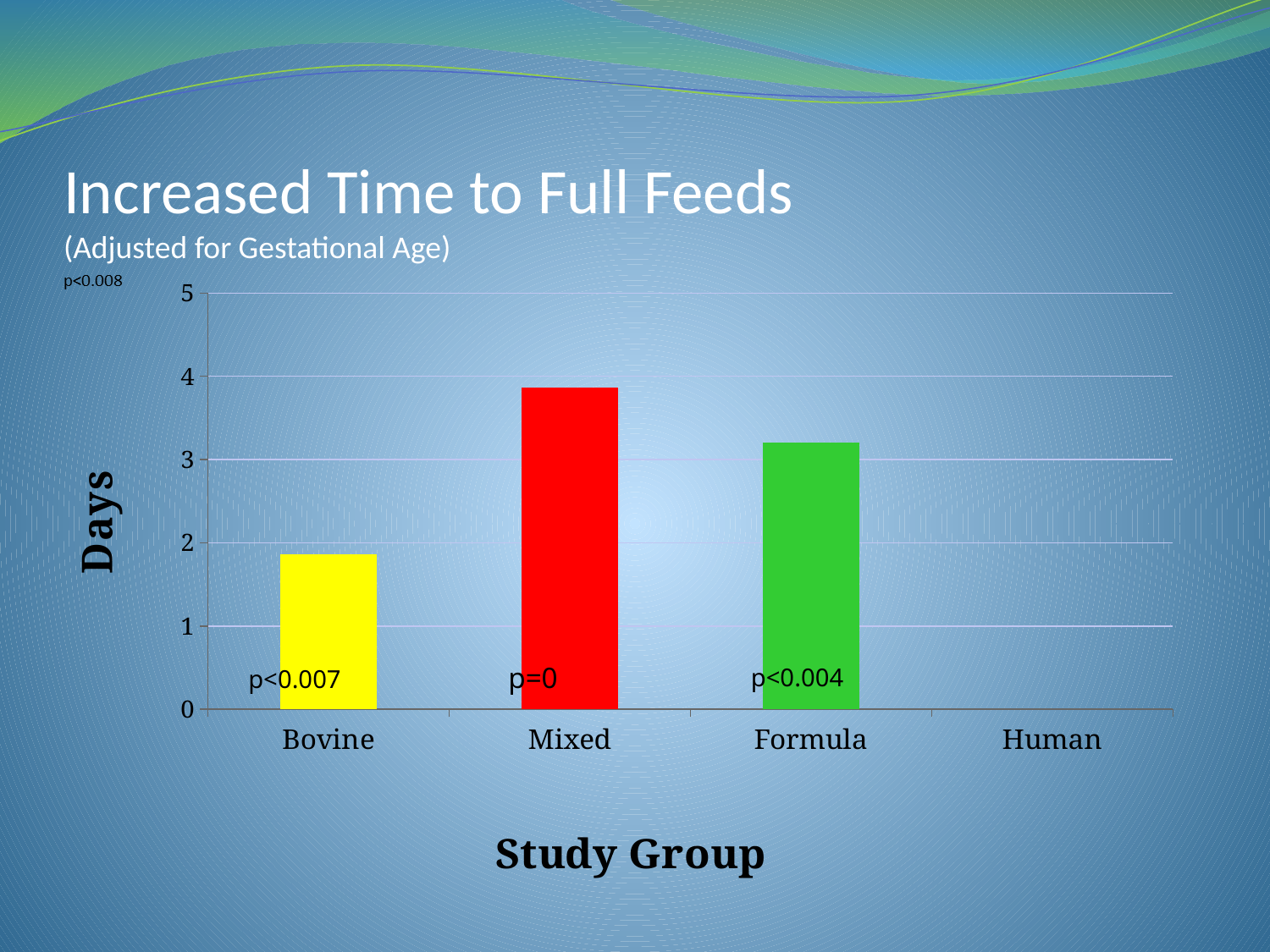
What kind of chart is shown on the slide? bar chart Is the value for Bovine greater or less than 2 days? less Is the value for Mixed greater or less than 4 days? less Which study group has the tallest bar? Mixed Which study group has no visible bar (the lowest value)? Human Is the value for Mixed greater or less than 3 days? greater Which has the larger value, Mixed or Formula? Mixed What is the label on the y axis of the chart? Days How many study groups are listed along the x axis? 4 Which has the larger value, Bovine or Formula? Formula What p-value label is printed on the Bovine bar? p<0.007